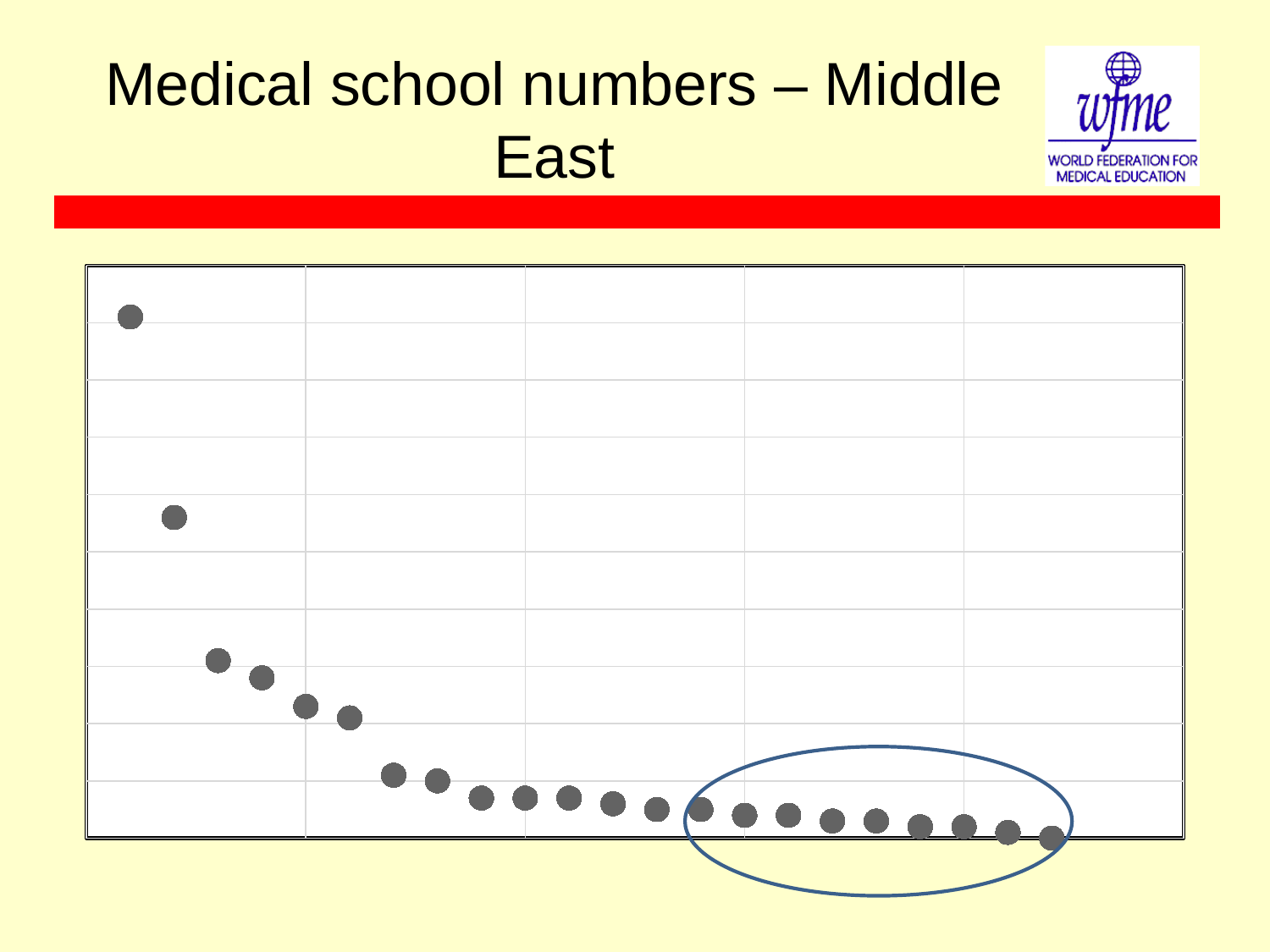
Do the plotted values rise or fall from left to right along the x axis? fall How many data points are plotted on the chart? 22 What kind of chart is shown on the slide? scatter chart Is the first (leftmost) point higher or lower than the second point? higher Which part of the chart is highlighted by the blue ellipse: the highest points or the lowest points? the lowest points Which point has the highest value, the leftmost or the rightmost? the leftmost Which point has the lowest value, the leftmost or the rightmost? the rightmost What is the title of the slide containing the chart? Medical school numbers – Middle East